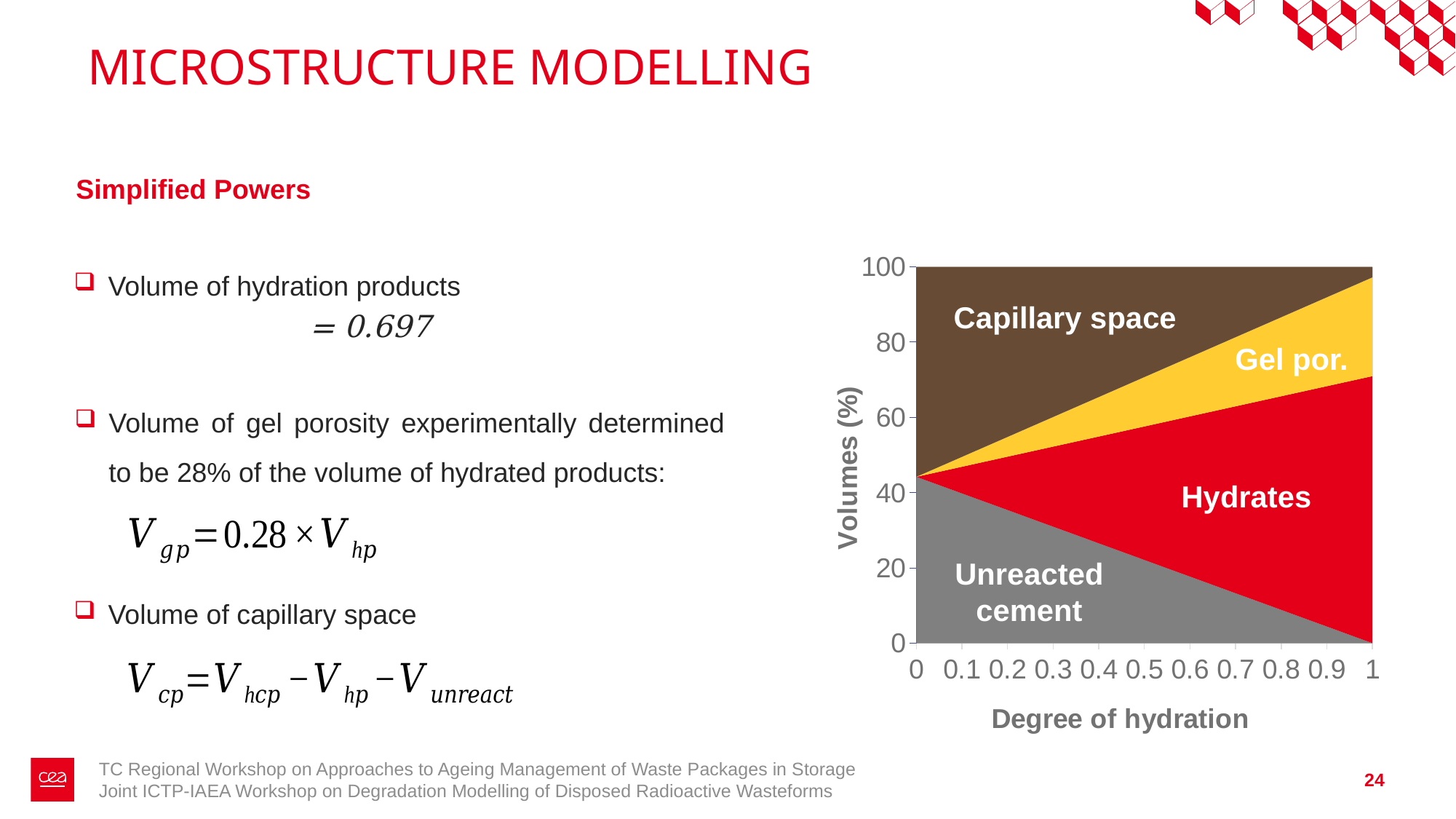
How many labelled regions does the chart show? 4 What is the title of the y axis of the chart? Volumes (%) Does the volume of hydrates rise or fall as the degree of hydration increases? rise Which region occupies the largest volume at a degree of hydration of 0? Capillary space Does the volume of unreacted cement rise or fall as the degree of hydration increases? fall At a degree of hydration of 0, is the volume of capillary space greater or less than 40%? greater What kind of chart is shown on the slide? area chart At a degree of hydration of 1, is the volume of capillary space greater or less than 20%? less At a degree of hydration of 1, is the volume of hydrates greater or less than 60%? greater What is the title of the x axis of the chart? Degree of hydration Which region occupies the largest volume at a degree of hydration of 1? Hydrates Does the volume of capillary space rise or fall as the degree of hydration increases? fall